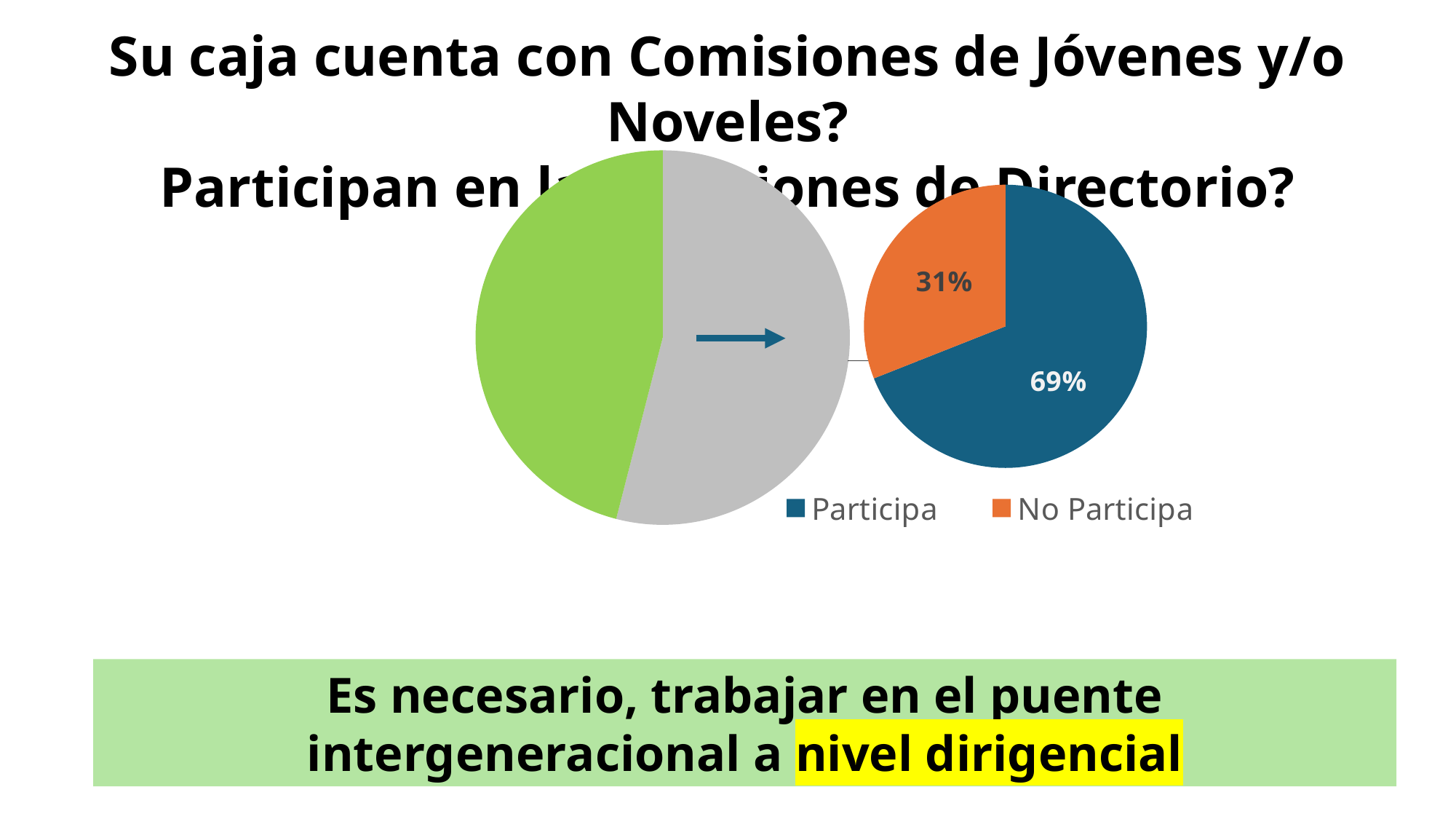
In the right-hand pie chart, what colour is the Participa slice? Dark blue In the right-hand pie chart, what percentage is shown for Participa? 69% What kind of chart is the right-hand chart on the slide? Pie chart In the right-hand pie chart, how many categories does the legend list? 2 How many slices does the left-hand pie chart have? 2 In the right-hand pie chart, which category has the largest share? Participa What kind of chart is the left-hand chart on the slide? Pie chart In the right-hand pie chart, which category has the smallest share? No Participa In the right-hand pie chart, which is larger, Participa or No Participa? Participa In the right-hand pie chart, what is the difference in percentage points between Participa and No Participa? 38 In the right-hand pie chart, what colour is the No Participa slice? Orange In the right-hand pie chart, what percentage is shown for No Participa? 31%